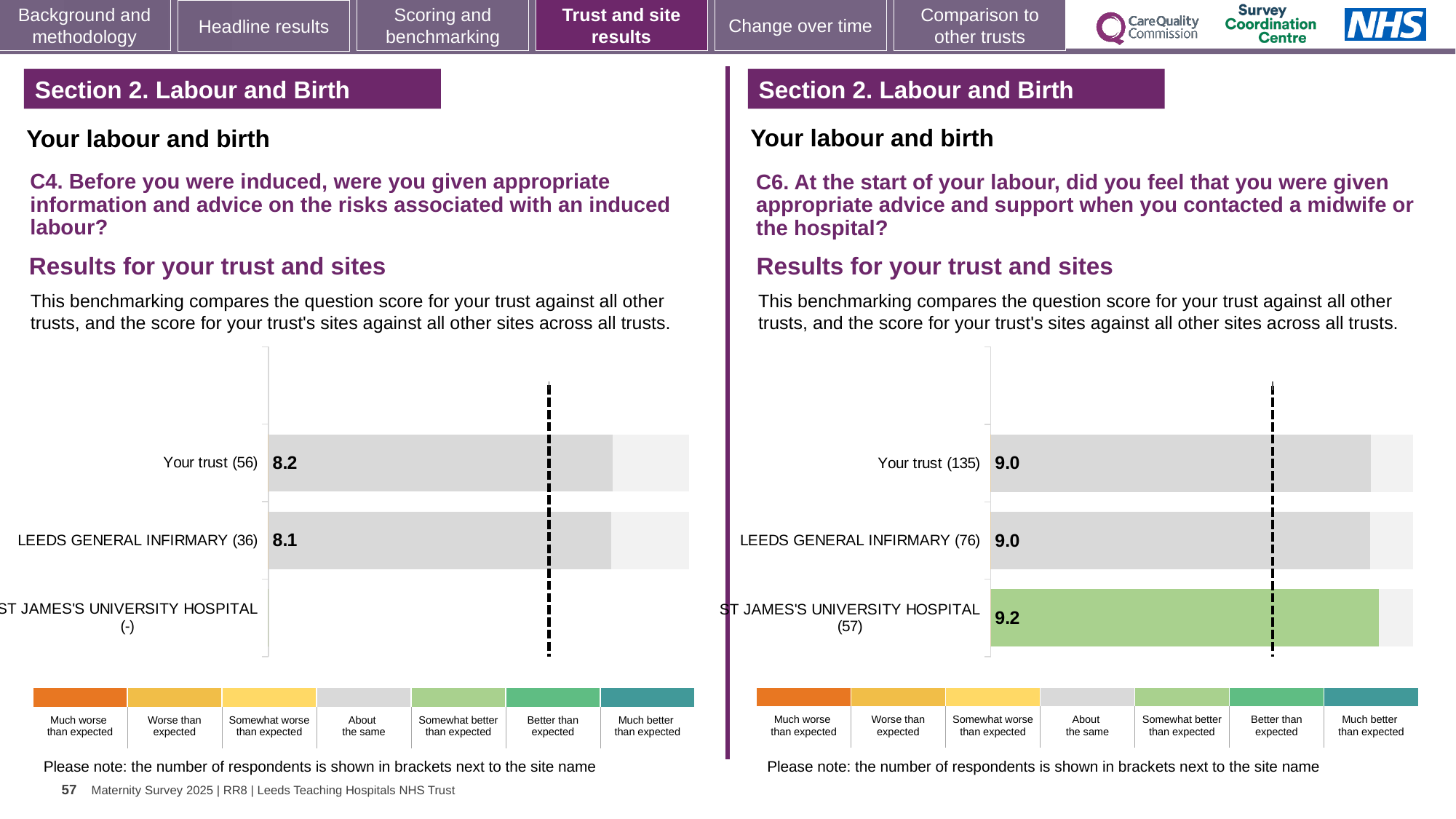
In the left chart (C4), what is the difference between the score for Your trust and the score for LEEDS GENERAL INFIRMARY? 0.1 In the right chart (C6), is the score for Your trust larger than, smaller than, or equal to the score for LEEDS GENERAL INFIRMARY? equal In the right chart (C6), what is the score for ST JAMES'S UNIVERSITY HOSPITAL? 9.2 In the right chart (C6), what is the difference between the score for ST JAMES'S UNIVERSITY HOSPITAL and the score for LEEDS GENERAL INFIRMARY? 0.2 In the left chart (C4), what is the score for Your trust? 8.2 In the right chart (C6), which benchmark category does the colour of the ST JAMES'S UNIVERSITY HOSPITAL bar correspond to? Somewhat better than expected How many respondents are shown in brackets for Your trust in the right chart (C6)? 135 What kind of chart is used on the left (C4)? bar chart In the right chart (C6), what is the score for Your trust? 9.0 How many respondents are shown in brackets for LEEDS GENERAL INFIRMARY in the left chart (C4)? 36 In the right chart (C6), which site or trust has the highest score? ST JAMES'S UNIVERSITY HOSPITAL In the left chart (C4), what is the score for LEEDS GENERAL INFIRMARY? 8.1